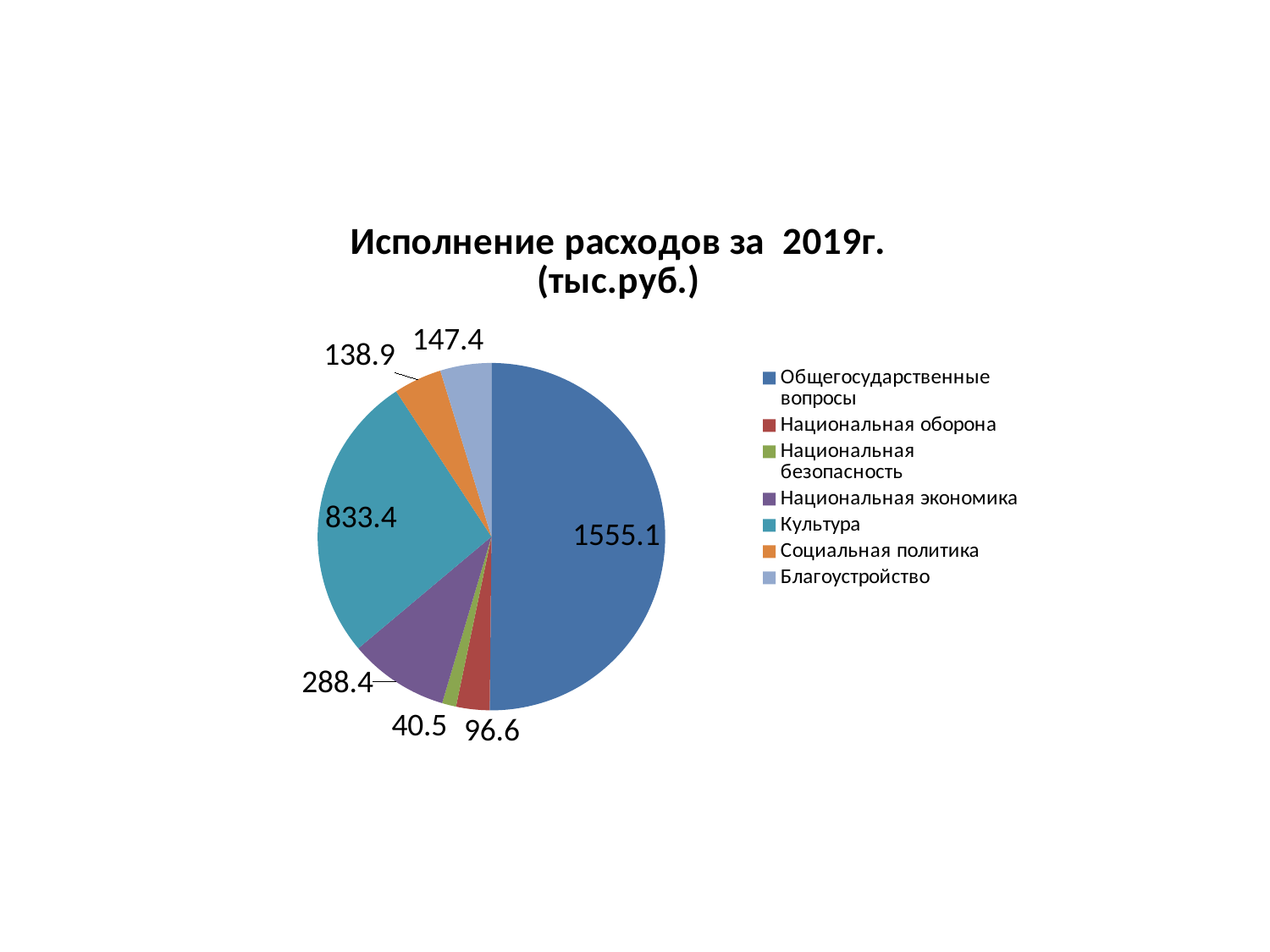
Which category has the largest slice? Общегосударственные вопросы What is the difference between Общегосударственные вопросы and Культура? 721.7 How many categories does the legend list? 7 What is the value for Национальная экономика? 288.4 What is the value for Культура? 833.4 What is the difference between Национальная экономика and Национальная оборона? 191.8 What is the value for Общегосударственные вопросы? 1555.1 Which is larger, Социальная политика or Благоустройство? Благоустройство What type of chart is shown on the slide? pie chart What is the value for Благоустройство? 147.4 Which category has the smallest slice? Национальная безопасность What is the title of the chart? Исполнение расходов за 2019г. (тыс.руб.)